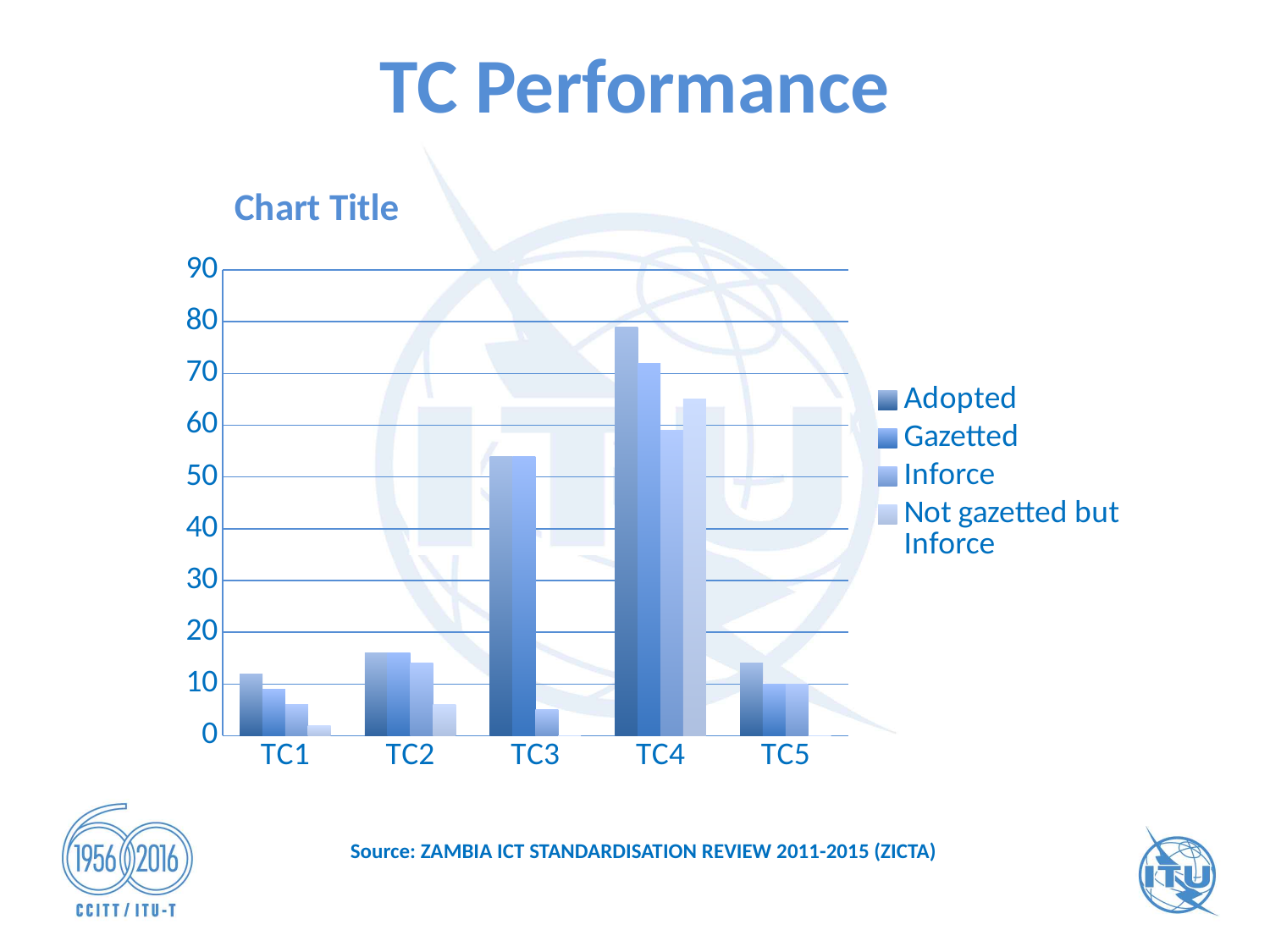
What kind of chart is shown on the slide? bar chart What is the last entry listed in the legend? Not gazetted but Inforce Is the Adopted value for TC4 greater or less than 70? greater Which has the larger Adopted value, TC3 or TC5? TC3 Which TC has the highest Adopted value? TC4 How many series does the legend list? 4 For TC4, which is larger, the Gazetted value or the Inforce value? Gazetted What is the title shown above the chart? Chart Title Is the Adopted value for TC1 greater or less than 20? less Is the Not gazetted but Inforce value for TC4 greater or less than 60? greater How many TC categories are shown on the x axis? 5